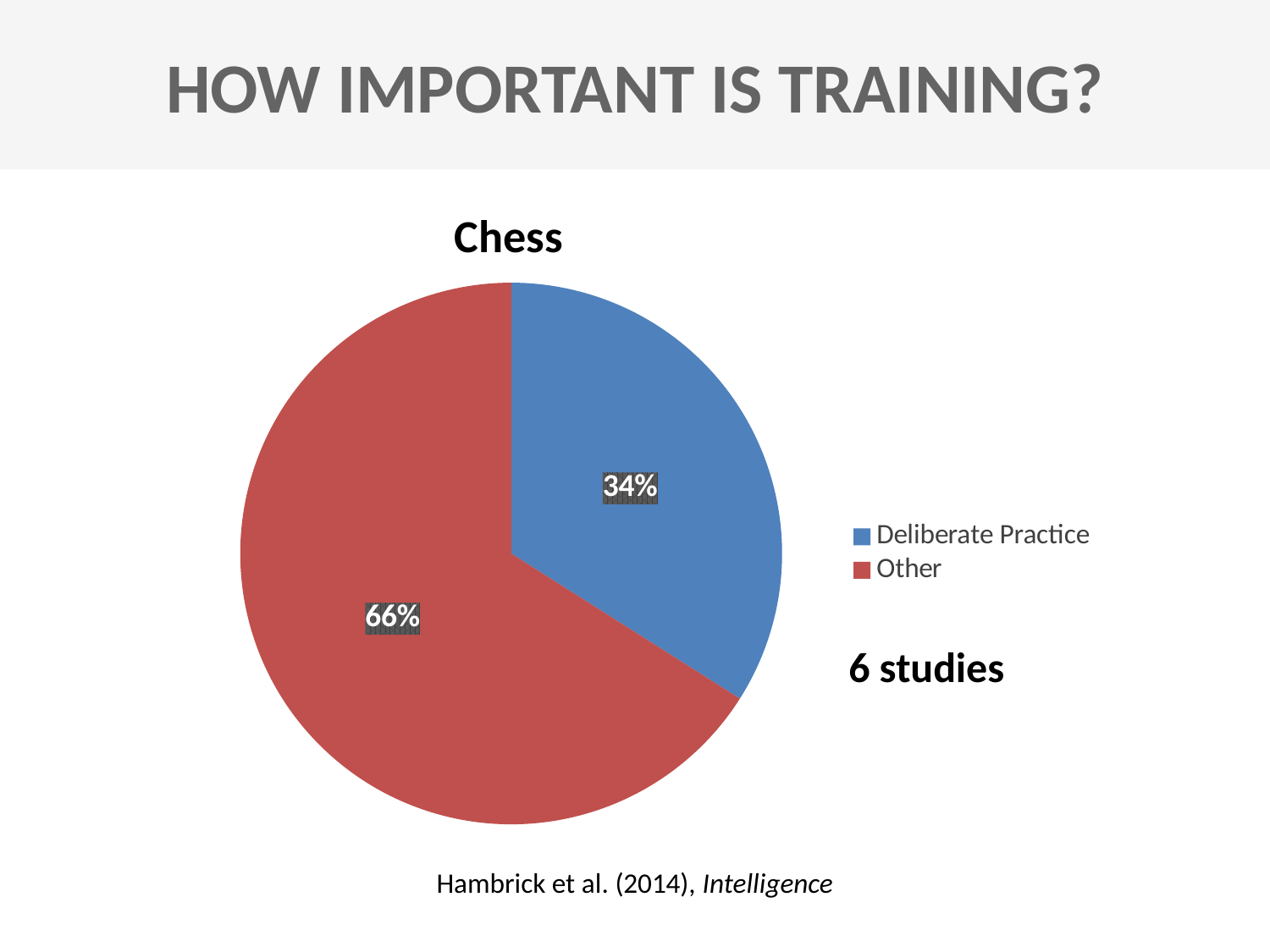
Which slice of the pie is the smallest? Deliberate Practice What kind of chart is shown on the slide? Pie chart How many entries does the legend list? 2 What is the difference in percentage points between the Other slice and the Deliberate Practice slice? 32 What share of the pie does the Deliberate Practice slice take? 34% What colour is the Other slice in the pie chart? Red What is the title of the chart? Chess Which is larger, the Deliberate Practice slice or the Other slice? Other What percentage of the pie is labelled Other? 66% How many slices does the pie chart have? 2 Which slice of the pie is the largest? Other What percentage of the pie is labelled Deliberate Practice? 34%